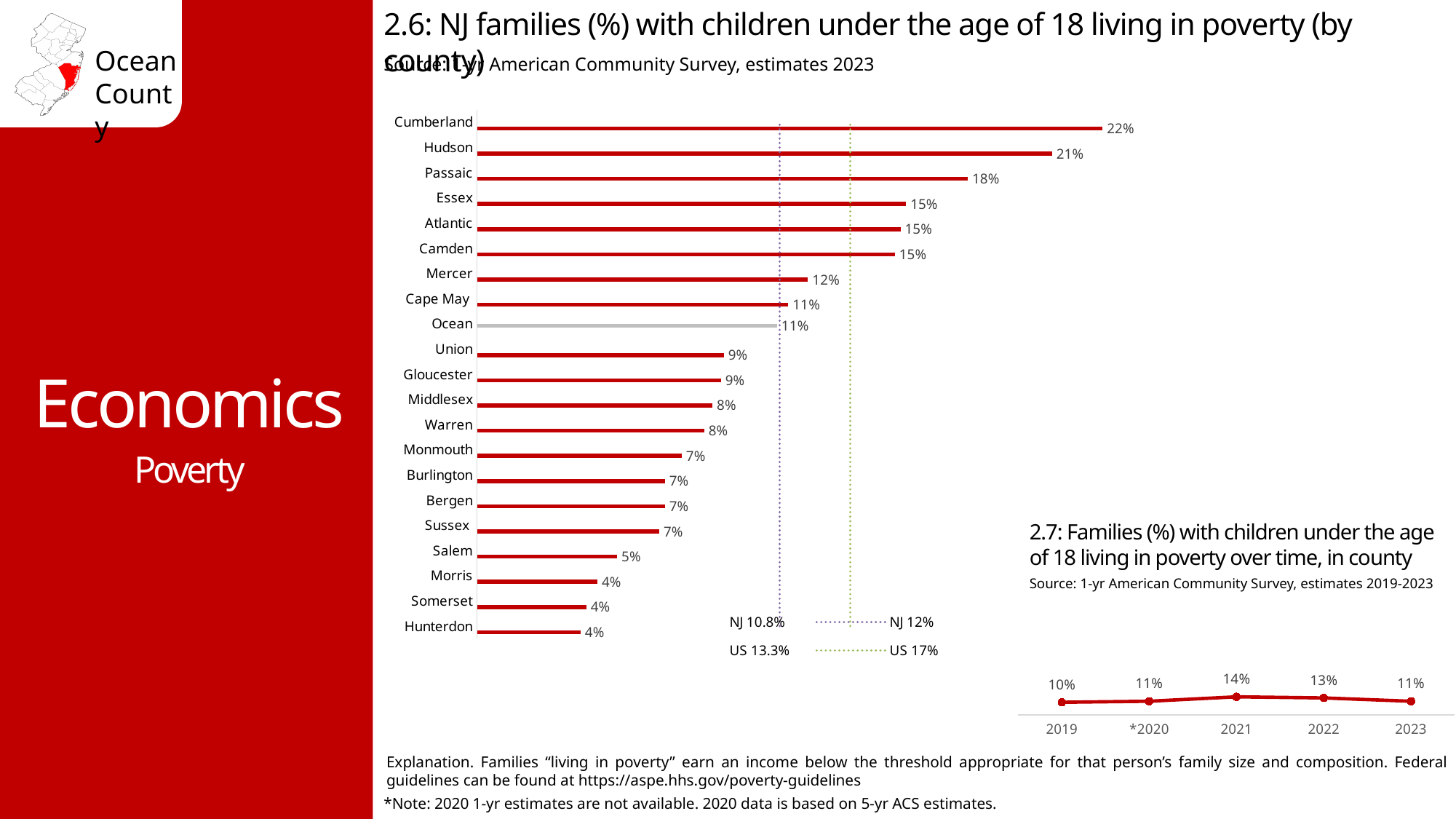
In chart 2.7, which year has the lowest value? 2019 In chart 2.6, what value is shown for Salem County? 5% In chart 2.7, what was the percentage of families with children living in poverty in the county in 2021? 14% In chart 2.6, which has a higher value, Mercer or Union? Mercer In chart 2.6, how many counties are plotted? 21 In chart 2.6, which county has the highest percentage of families with children living in poverty? Cumberland What kind of chart is chart 2.6? Bar chart In chart 2.6, what percentage of families with children under 18 live in poverty in Cumberland County? 22% In chart 2.6, what is the difference between the values for Hudson and Passaic? 3% In chart 2.6, what is the value shown for Ocean County? 11% In chart 2.7, how many years are plotted? 5